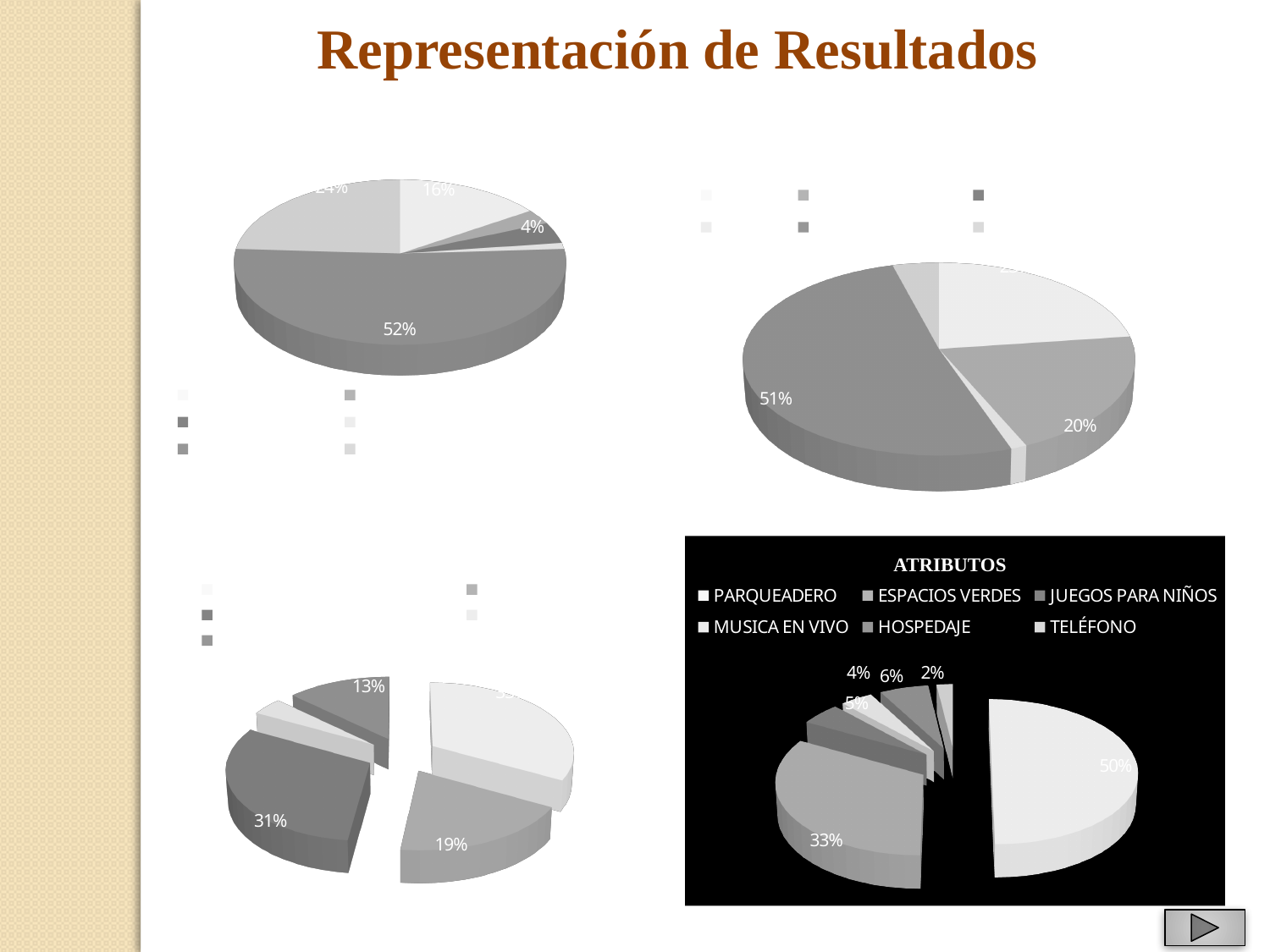
In the pie chart at the top right of the slide, what is the percentage of the largest slice? 51% In the ATRIBUTOS chart, what share does ESPACIOS VERDES have? 33% How many entries does the legend of the ATRIBUTOS chart list? 6 In the ATRIBUTOS chart, which category has the largest slice? PARQUEADERO In the ATRIBUTOS chart, what share does PARQUEADERO have? 50% In the ATRIBUTOS chart, which is larger, PARQUEADERO or ESPACIOS VERDES? PARQUEADERO In the ATRIBUTOS chart, what is the difference between the PARQUEADERO share and the ESPACIOS VERDES share? 17% What kind of chart is the ATRIBUTOS chart at the bottom right of the slide? pie chart What is the title of the chart at the bottom right of the slide? ATRIBUTOS In the ATRIBUTOS chart, what is the smallest percentage labelled on a slice? 2% In the pie chart at the top left of the slide, what is the percentage of the largest slice? 52%